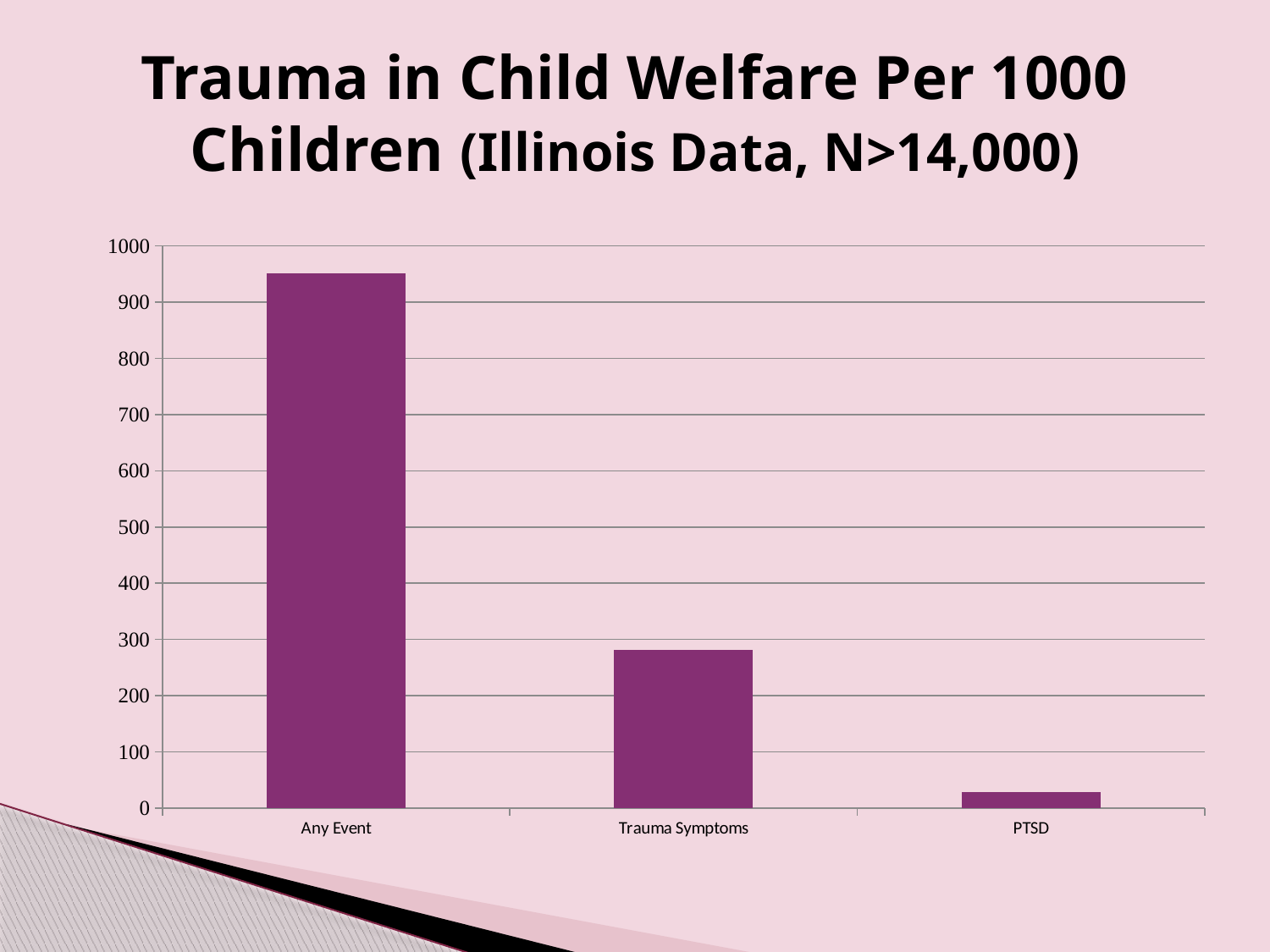
Which category has the highest value? Any Event Which is larger, the value for Trauma Symptoms or the value for PTSD? Trauma Symptoms Which category has the lowest value? PTSD Do the values rise or fall moving from left to right along the x axis? fall Is the value for Trauma Symptoms greater or less than 300? less How many categories are plotted on the x axis? 3 What kind of chart is shown on the slide? bar chart Is the value for PTSD greater or less than 100? less Is the value for Any Event greater or less than 900? greater What is the title of the slide containing the chart? Trauma in Child Welfare Per 1000 Children (Illinois Data, N>14,000) Which is larger, the value for Any Event or the value for Trauma Symptoms? Any Event